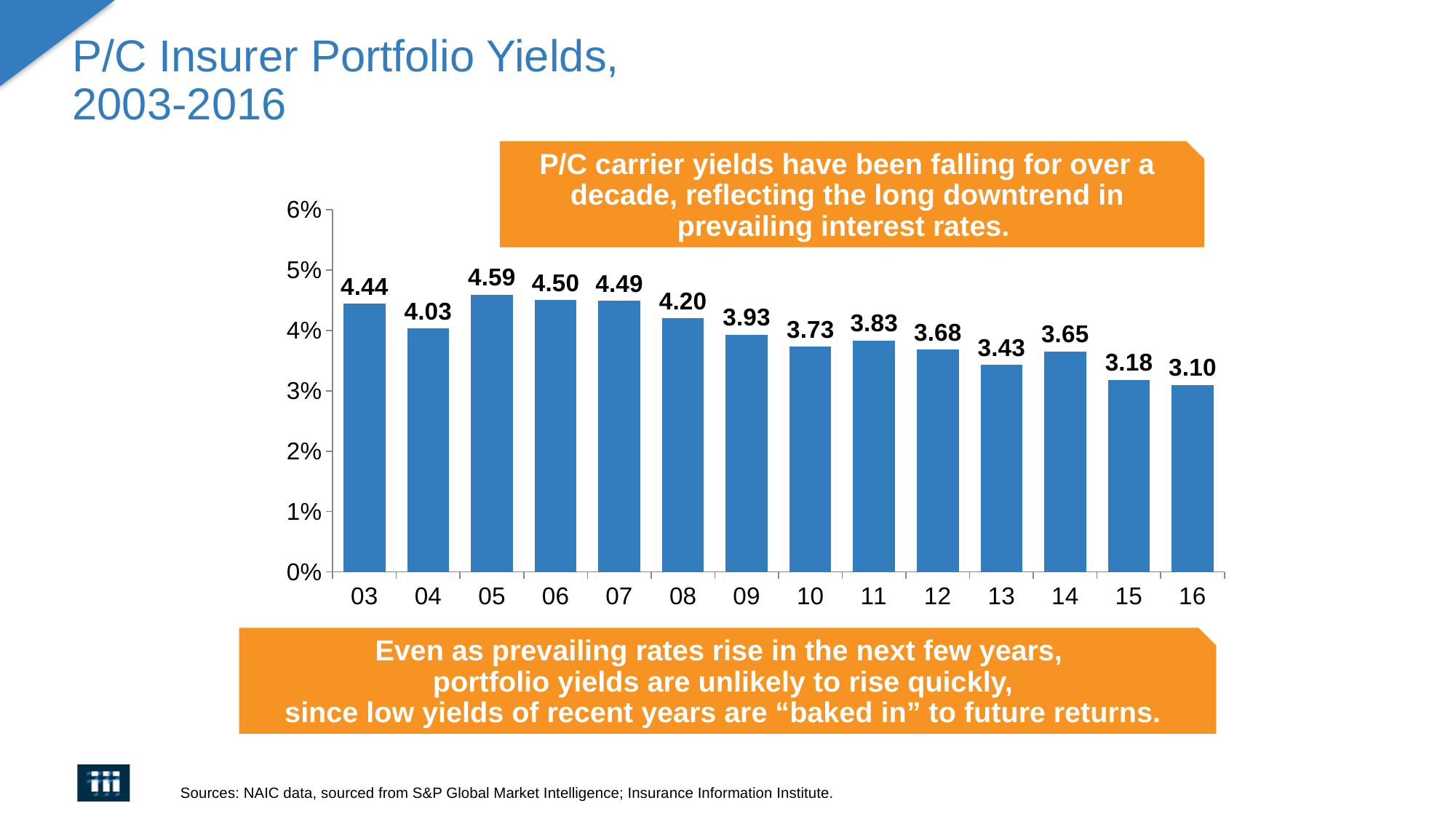
What is the portfolio yield value shown for 2016? 3.10 Which year has the highest portfolio yield? 05 What is the portfolio yield value shown for 2005? 4.59 Which year has a higher yield, 2011 or 2012? 11 What is the portfolio yield value shown for 2010? 3.73 Is the value for 2013 greater or less than 4%? less What is the difference between the yield in 2003 and the yield in 2016? 1.34 Which year has the lowest portfolio yield? 16 What kind of chart is shown on the slide? bar chart What is the title of the chart on the slide? P/C Insurer Portfolio Yields, 2003-2016 Do the portfolio yields generally rise or fall from 2003 to 2016? fall How many years are shown on the x axis? 14